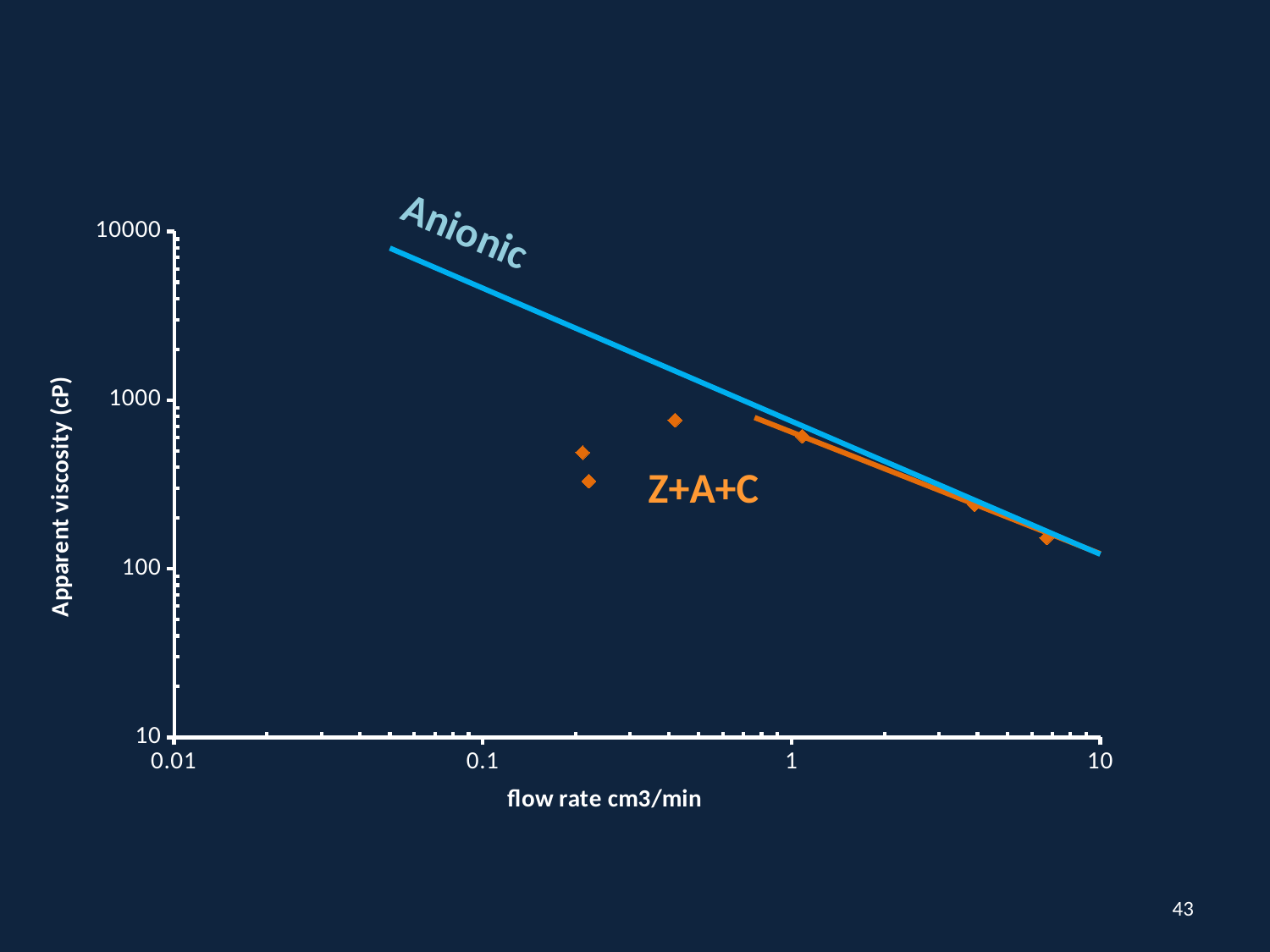
How many series are labelled on the chart? 2 Does apparent viscosity rise or fall as flow rate increases along the x axis? fall At a flow rate of about 1 cm3/min, which series shows the higher apparent viscosity, Anionic or Z+A+C? Anionic Is the Anionic line at a flow rate of 10 cm3/min greater or less than 100 cP? greater Is the Anionic line at a flow rate of 0.1 cm3/min greater or less than 1000 cP? greater What are the names of the two series labelled on the chart? Anionic and Z+A+C Are all the Z+A+C data points greater or less than 1000 cP? less What kind of chart is shown on the slide? scatter chart with trend lines How many Z+A+C data points are plotted on the chart? 6 What is the lowest value shown on the y axis? 10 What is the title of the y axis? Apparent viscosity (cP)